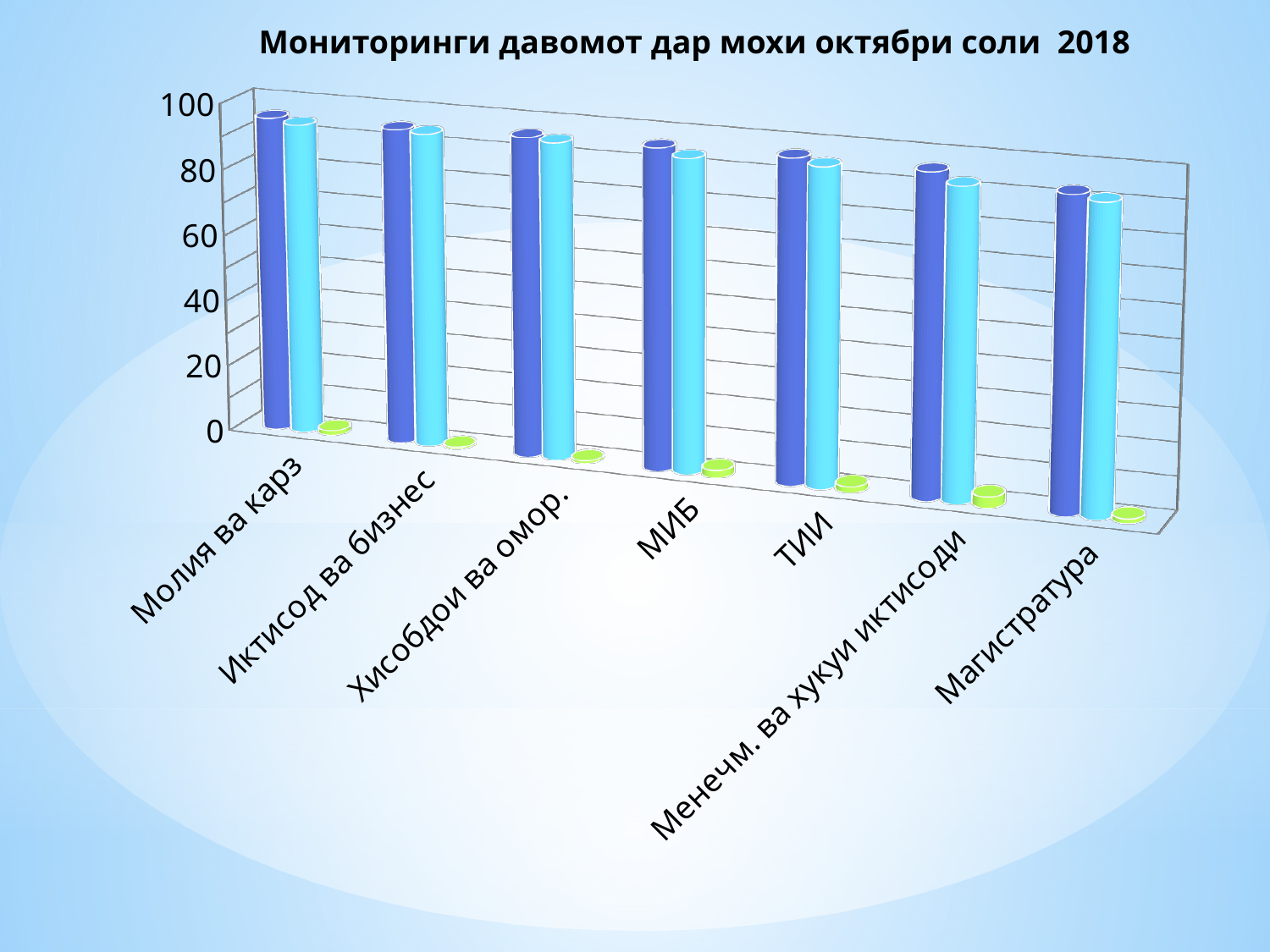
Is the dark blue bar for Молия ва карз greater or less than 80? greater What kind of chart is shown on the slide? bar chart Which category has the shortest light blue bar? Магистратура Is the green bar for МИБ greater or less than 20? less How many categories are shown on the x axis of the chart? 7 What is the title of the chart? Мониторинги давомот дар мохи октябри соли 2018 Which category has the shortest dark blue bar? Магистратура What is the highest value shown on the vertical axis of the chart? 100 Is the dark blue bar for Магистратура greater or less than 60? greater